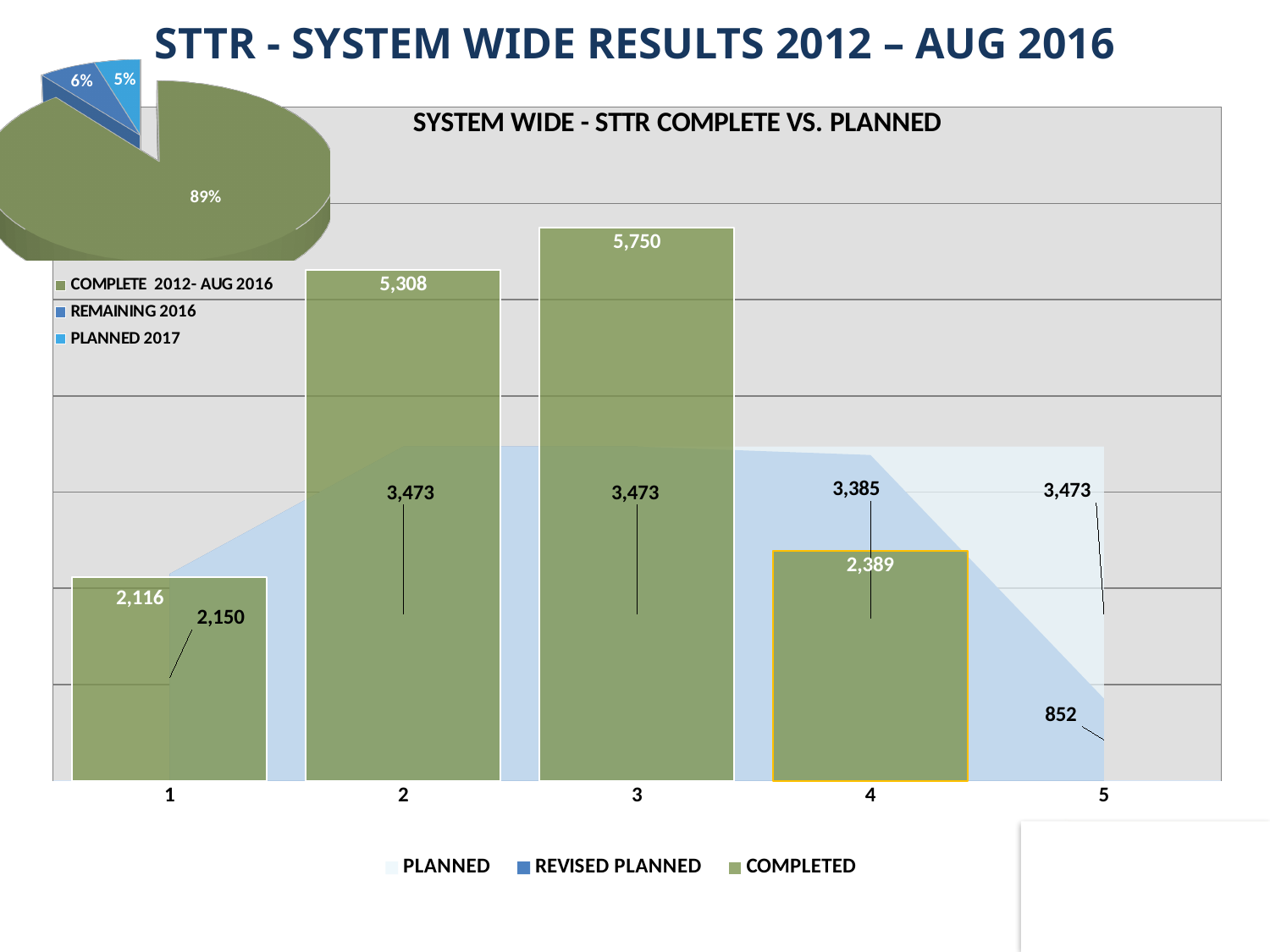
In the SYSTEM WIDE - STTR COMPLETE VS. PLANNED chart, what is the COMPLETED value for category 1? 2,116 In the SYSTEM WIDE - STTR COMPLETE VS. PLANNED chart, which category has the highest COMPLETED value? 3 In the pie chart at the top left, which slice is the smallest? PLANNED 2017 In the SYSTEM WIDE - STTR COMPLETE VS. PLANNED chart, what is the REVISED PLANNED value for category 5? 852 In the SYSTEM WIDE - STTR COMPLETE VS. PLANNED chart, is the COMPLETED value for category 2 larger or smaller than the PLANNED value for category 2? larger In the pie chart at the top left, what share does PLANNED 2017 have? 5% In the SYSTEM WIDE - STTR COMPLETE VS. PLANNED chart, what is the difference between the COMPLETED values for categories 3 and 2? 442 In the SYSTEM WIDE - STTR COMPLETE VS. PLANNED chart, what is the COMPLETED value for category 3? 5,750 In the pie chart at the top left, what share does COMPLETE 2012- AUG 2016 have? 89% In the SYSTEM WIDE - STTR COMPLETE VS. PLANNED chart, what is the COMPLETED value for category 4? 2,389 In the SYSTEM WIDE - STTR COMPLETE VS. PLANNED chart, how many series does the legend list? 3